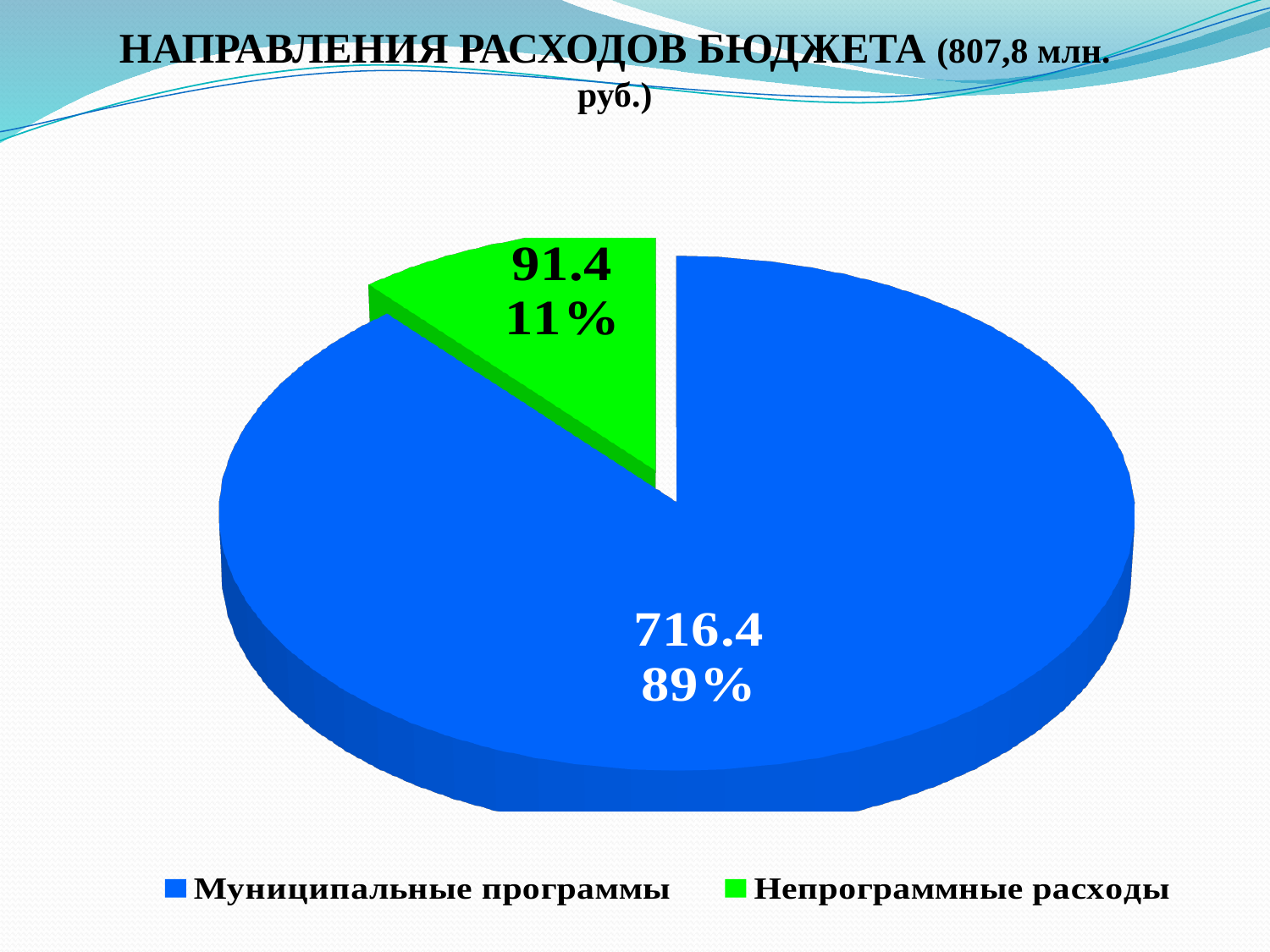
What colour is the slice for Непрограммные расходы? green How many categories does the pie chart have? 2 What share of the pie does Муниципальные программы represent? 89% What is the value for Непрограммные расходы? 91.4 What is the value for Муниципальные программы? 716.4 What type of chart is shown on the slide? pie chart What is the difference between the values for Муниципальные программы and Непрограммные расходы? 625.0 Which category has the largest slice? Муниципальные программы What is the title of the chart? НАПРАВЛЕНИЯ РАСХОДОВ БЮДЖЕТА (807,8 млн. руб.) Which category has the smallest slice? Непрограммные расходы What share of the pie does Непрограммные расходы represent? 11% Which is larger, Муниципальные программы or Непрограммные расходы? Муниципальные программы